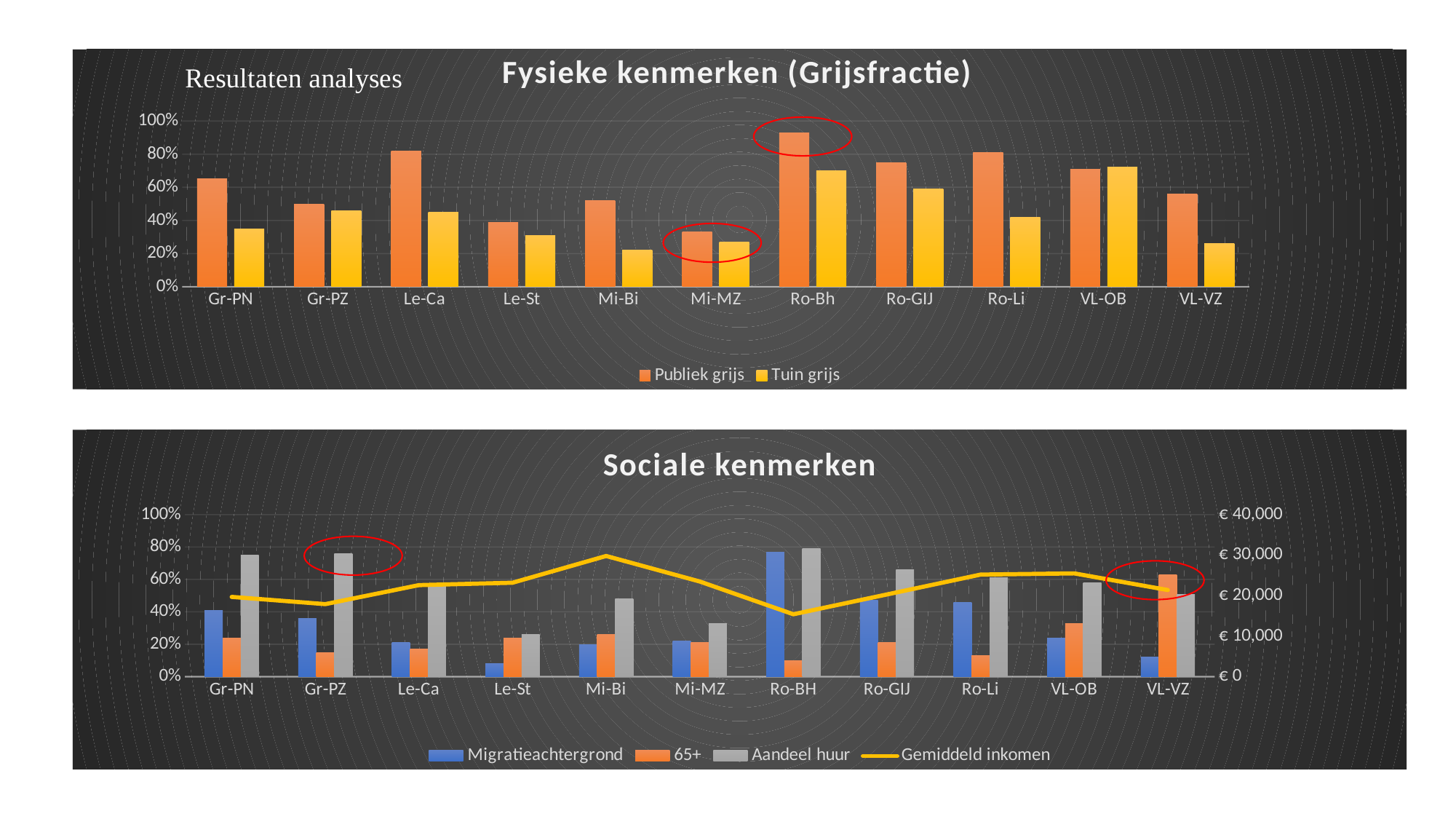
In the chart titled 'Fysieke kenmerken (Grijsfractie)', which category has the lowest value for Publiek grijs? Mi-MZ In the chart titled 'Fysieke kenmerken (Grijsfractie)', which is larger for Le-Ca: Publiek grijs or Tuin grijs? Publiek grijs In the chart titled 'Sociale kenmerken', which category has the lowest value for Migratieachtergrond? Le-St In the chart titled 'Fysieke kenmerken (Grijsfractie)', how many categories are shown on the x axis? 11 In the chart titled 'Sociale kenmerken', which category has the lowest Gemiddeld inkomen? Ro-BH In the chart titled 'Sociale kenmerken', how many series does the legend list? 4 In the chart titled 'Fysieke kenmerken (Grijsfractie)', is the Publiek grijs value for Ro-Bh greater or less than 80%? greater In the chart titled 'Fysieke kenmerken (Grijsfractie)', how many series does the legend list? 2 In the chart titled 'Sociale kenmerken', is the Gemiddeld inkomen for Ro-BH greater or less than € 20,000? less In the chart titled 'Fysieke kenmerken (Grijsfractie)', is the Tuin grijs value for Gr-PN greater or less than 40%? less In the chart titled 'Sociale kenmerken', which category has the highest value for Migratieachtergrond? Ro-BH In the chart titled 'Fysieke kenmerken (Grijsfractie)', which category has the highest value for Publiek grijs? Ro-Bh